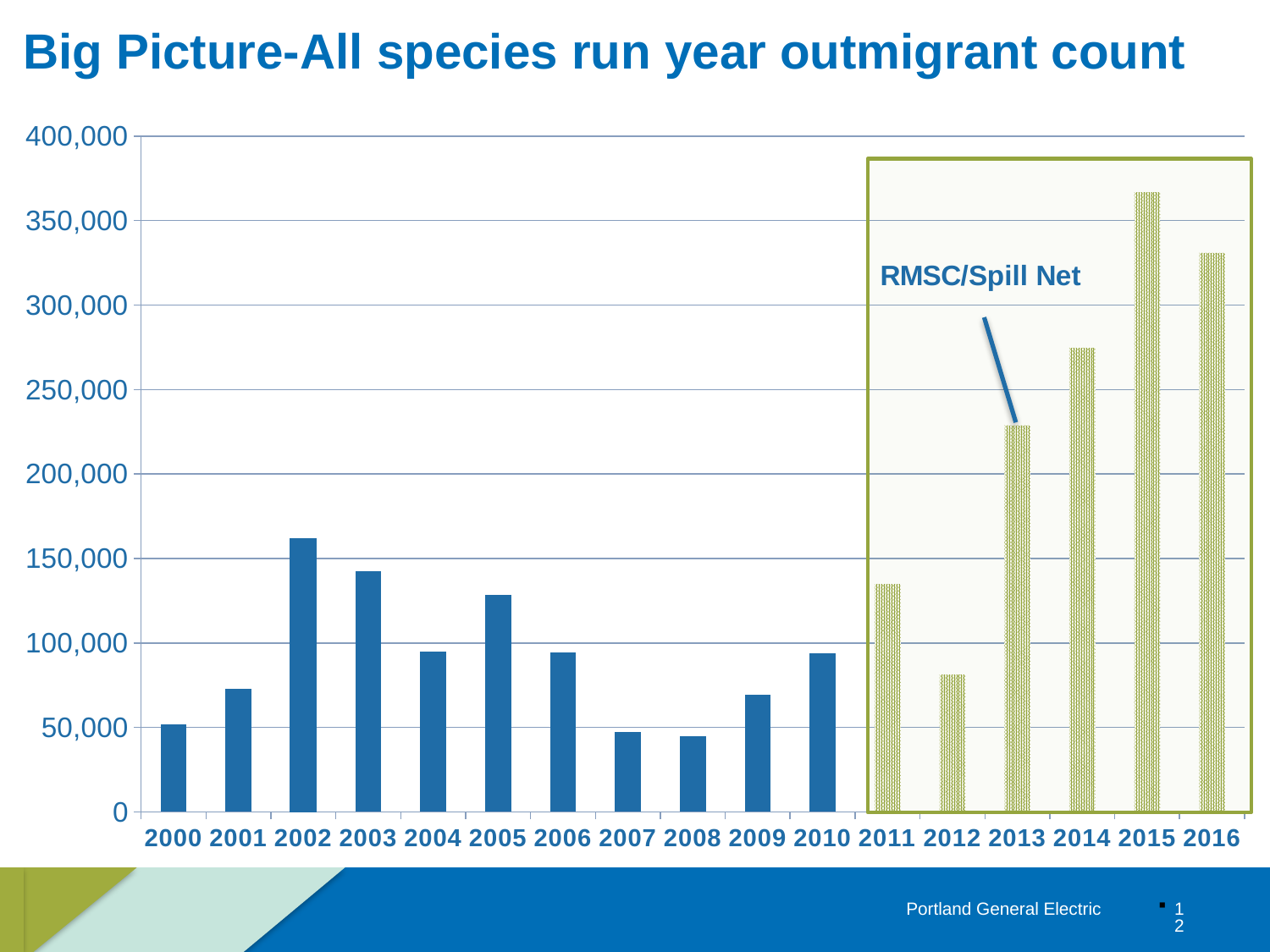
Do the values rise or fall from 2013 to 2015? rise Is the value for 2015 greater or less than 350,000? greater How many years are shown on the x axis of the chart? 17 Is the value for 2008 greater or less than 50,000? less Is the value for 2013 greater or less than 200,000? greater Which year has the highest outmigrant count? 2015 Which year has the larger outmigrant count, 2002 or 2003? 2002 What label is shown inside the highlighted box covering the 2011 to 2016 bars? RMSC/Spill Net What kind of chart is shown on the slide? bar chart Which year has the larger outmigrant count, 2013 or 2014? 2014